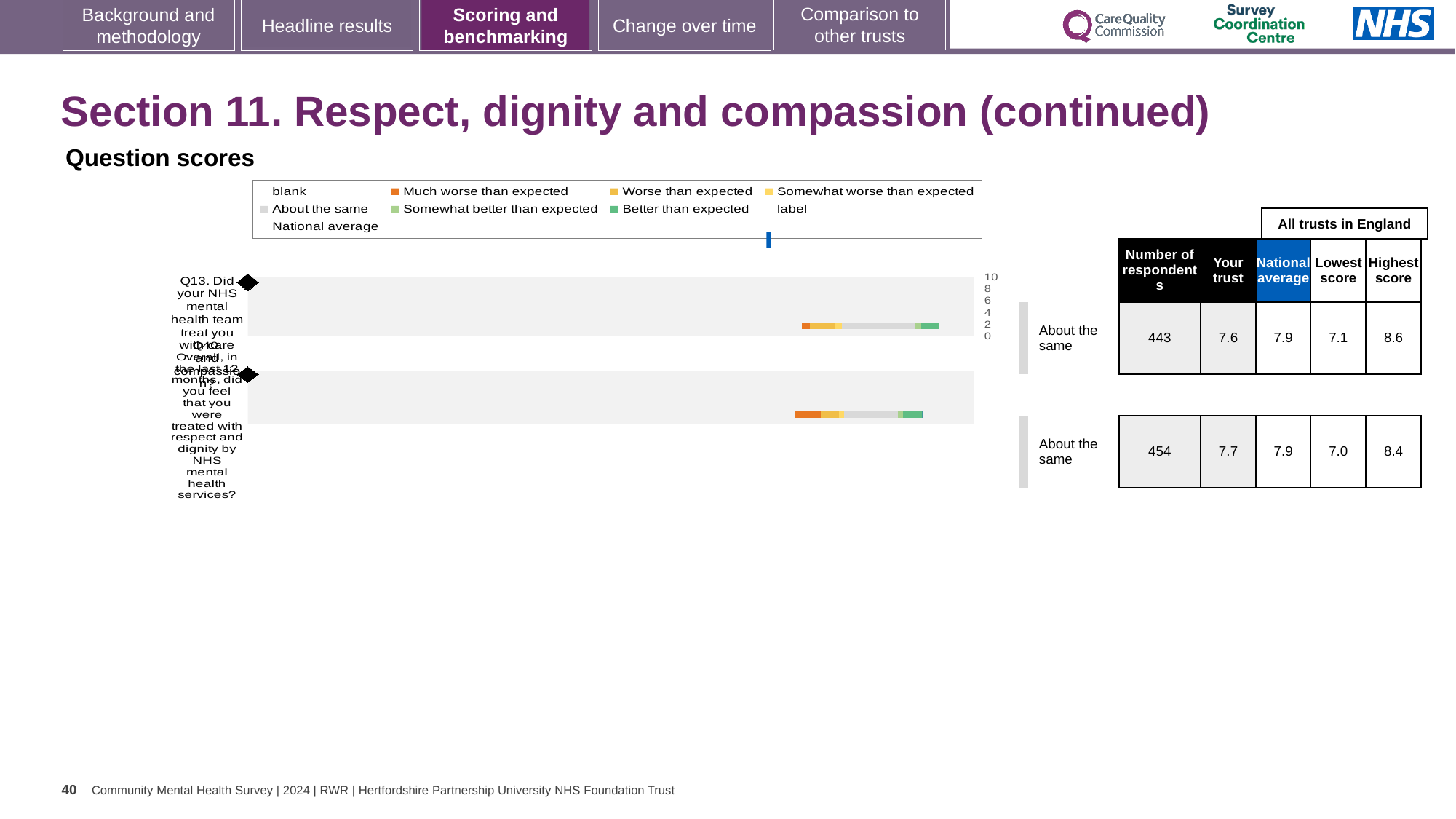
What kind of chart is used to show the question scores on this slide? bar chart Which question has the lower 'Lowest score' across all trusts in England? Q14 What is the difference between the highest and lowest scores for Q14? 1.4 What benchmark category is shown for Q13 and Q14? About the same Which question has the higher 'Highest score' across all trusts in England? Q13 What is the 'Your trust' score for Q13? 7.6 Which is larger for Q13, the 'Your trust' score or the national average? National average How many questions are plotted in the question scores chart? 2 What is the national average score for Q13? 7.9 What is the 'Your trust' score for Q14? 7.7 What is the highest score among all trusts in England for Q13? 8.6 How many respondents answered Q14? 454